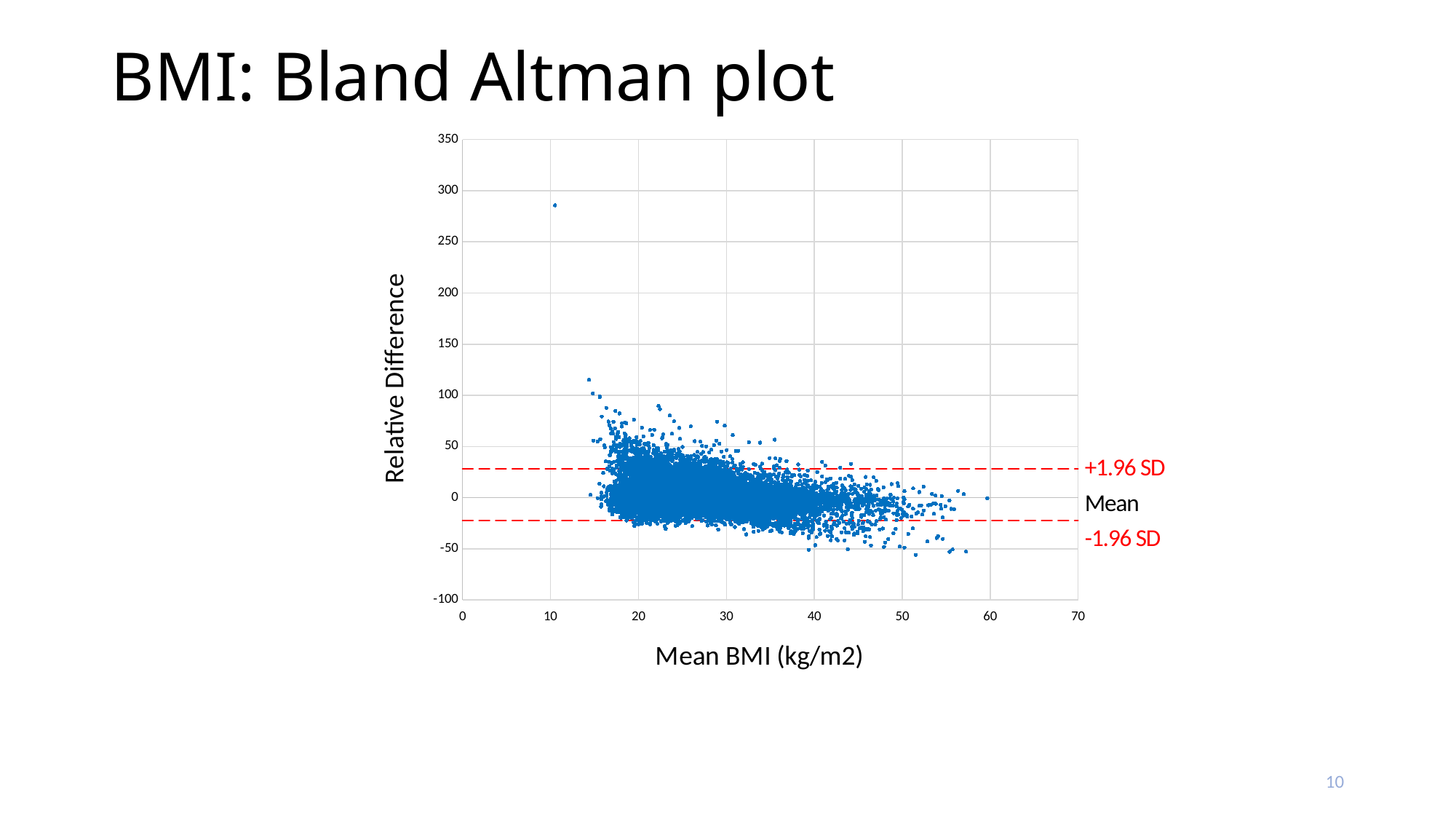
What is the highest value shown on the x axis? 70 What is the title of the slide's chart? BMI: Bland Altman plot Is the -1.96 SD dashed line greater or less than -50 on the Relative Difference axis? greater What is the lowest value shown on the Relative Difference axis? -100 What kind of chart is shown on the slide? scatter plot Which of the two dashed reference lines is higher on the chart, +1.96 SD or -1.96 SD? +1.96 SD Is the relative difference of the highest isolated point (near Mean BMI 10) greater or less than 250? greater Is the +1.96 SD dashed line greater or less than 50 on the Relative Difference axis? less